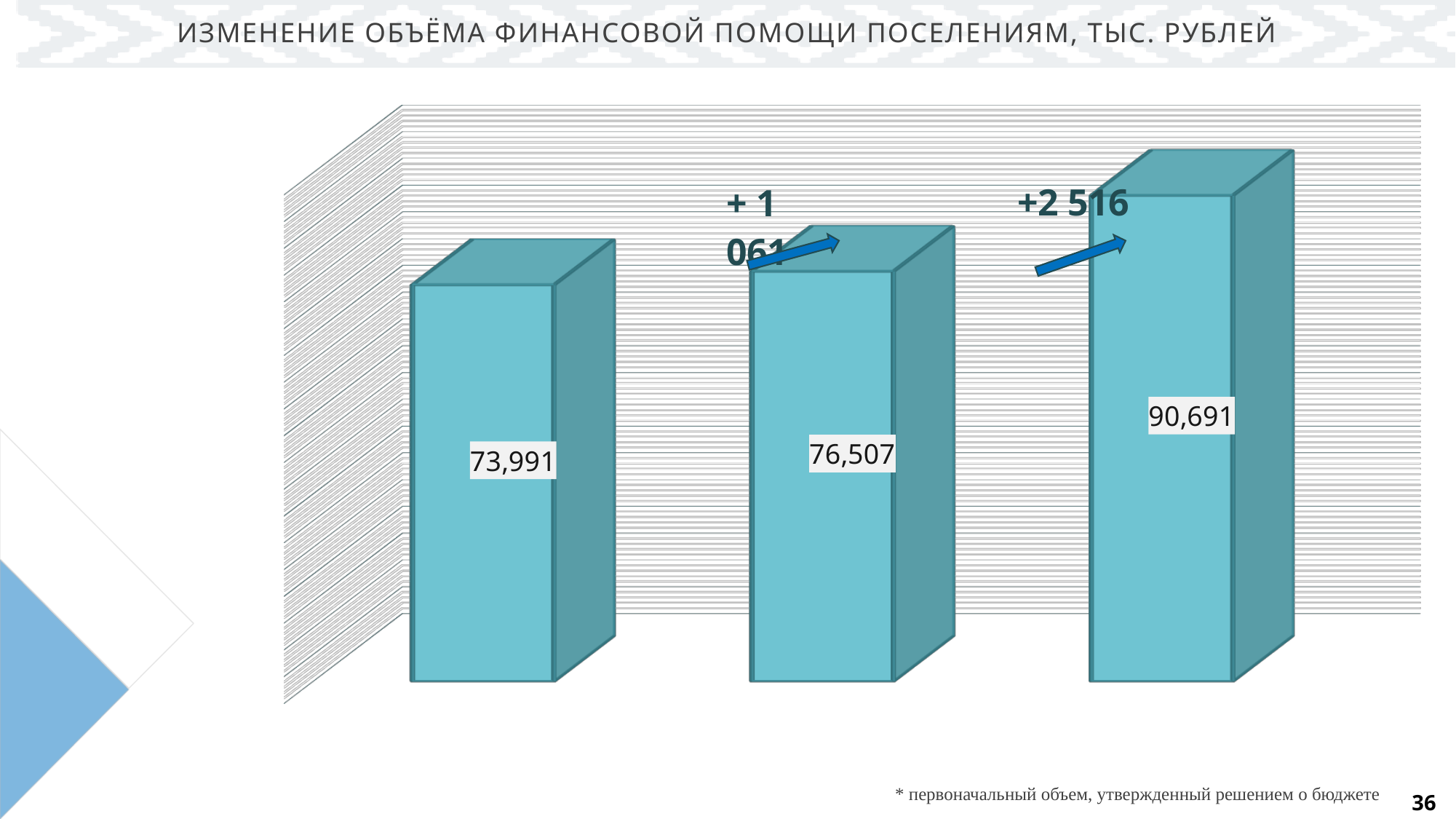
Which bar has the lowest value? The first (leftmost) bar, 73,991 What is the value of the first (leftmost) bar? 73,991 What is the title of the chart? ИЗМЕНЕНИЕ ОБЪЁМА ФИНАНСОВОЙ ПОМОЩИ ПОСЕЛЕНИЯМ, ТЫС. РУБЛЕЙ Which bar has the highest value? The third (rightmost) bar, 90,691 Do the values rise or fall from left to right across the bars? Rise What is the value of the middle bar? 76,507 What is the difference between the third bar and the middle bar? 14,184 Which is larger, the value of the first bar or the value of the third bar? The third bar (90,691) What is the difference between the middle bar and the first bar? 2,516 What is the value of the third (rightmost) bar? 90,691 How many bars are shown in the chart? 3 What type of chart is shown on the slide? Bar chart